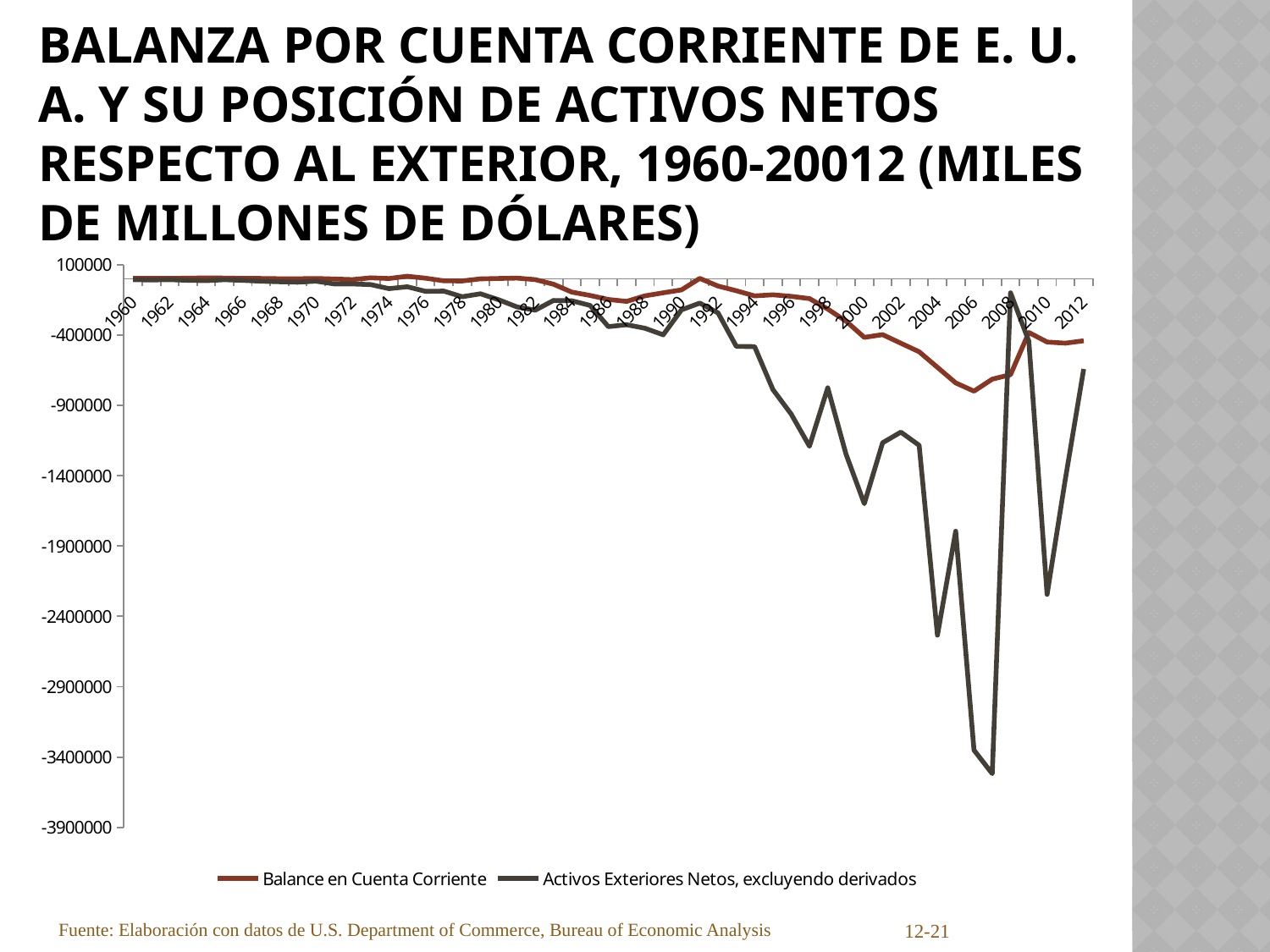
Which series reaches the lowest value anywhere on the chart? Activos Exteriores Netos, excluyendo derivados What kind of chart is shown on the slide? Line chart Does the Balance en Cuenta Corriente line generally rise or fall between 1992 and 2006? fall What is the lowest value shown on the vertical axis? -3900000 Is the lowest point of the Balance en Cuenta Corriente line greater or less than -1400000? greater Is the lowest point of the Activos Exteriores Netos, excluyendo derivados line greater or less than -2900000? less In 2012, which series has the higher value, Balance en Cuenta Corriente or Activos Exteriores Netos, excluyendo derivados? Balance en Cuenta Corriente How many series does the legend list? 2 Is the value of Activos Exteriores Netos, excluyendo derivados in 2000 greater or less than -900000? less In 2000, which series has the lower value, Balance en Cuenta Corriente or Activos Exteriores Netos, excluyendo derivados? Activos Exteriores Netos, excluyendo derivados Which series is drawn in the dark red/brown line according to the legend? Balance en Cuenta Corriente